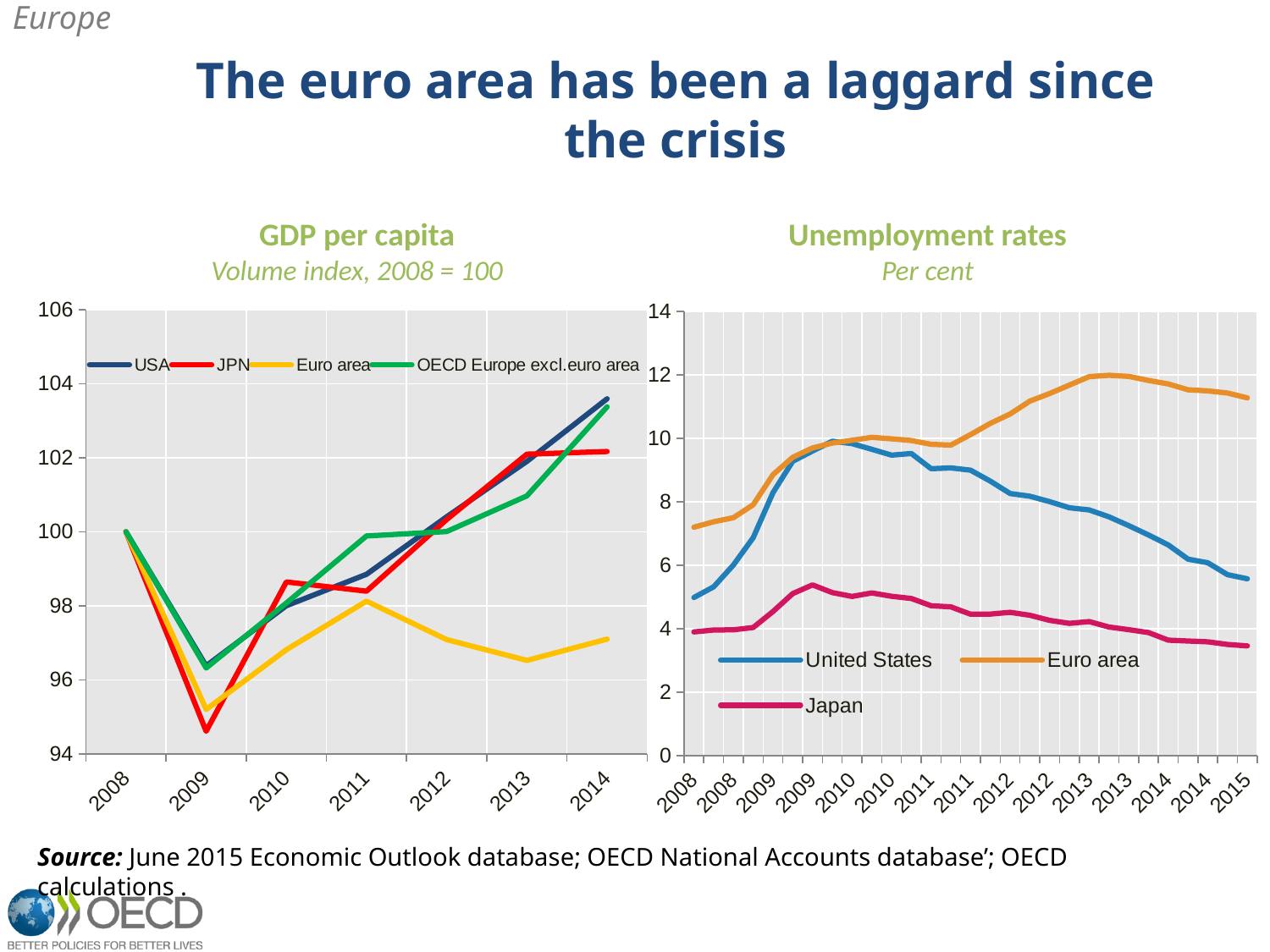
In the 'GDP per capita' chart, which series has the lowest value in 2014? Euro area How many series does the legend of the 'Unemployment rates' chart list? 3 In the 'GDP per capita' chart, is the value for the USA in 2014 greater or less than 102? greater How many series does the legend of the 'GDP per capita' chart list? 4 What kind of chart is the 'GDP per capita' chart? line chart In the 'GDP per capita' chart, what is the value for the USA in 2008? 100 In the 'GDP per capita' chart, is the value for the Euro area in 2014 greater or less than 98? less In the 'Unemployment rates' chart, does the Euro area unemployment rate rise or fall between 2008 and 2013? rise In the 'GDP per capita' chart, which series has the lowest value in 2009? JPN In the 'Unemployment rates' chart, is the value for the United States in 2015 greater or less than 6? less In the 'Unemployment rates' chart, which series has the lowest value in 2013? Japan In the 'Unemployment rates' chart, which series has the highest value in 2015? Euro area